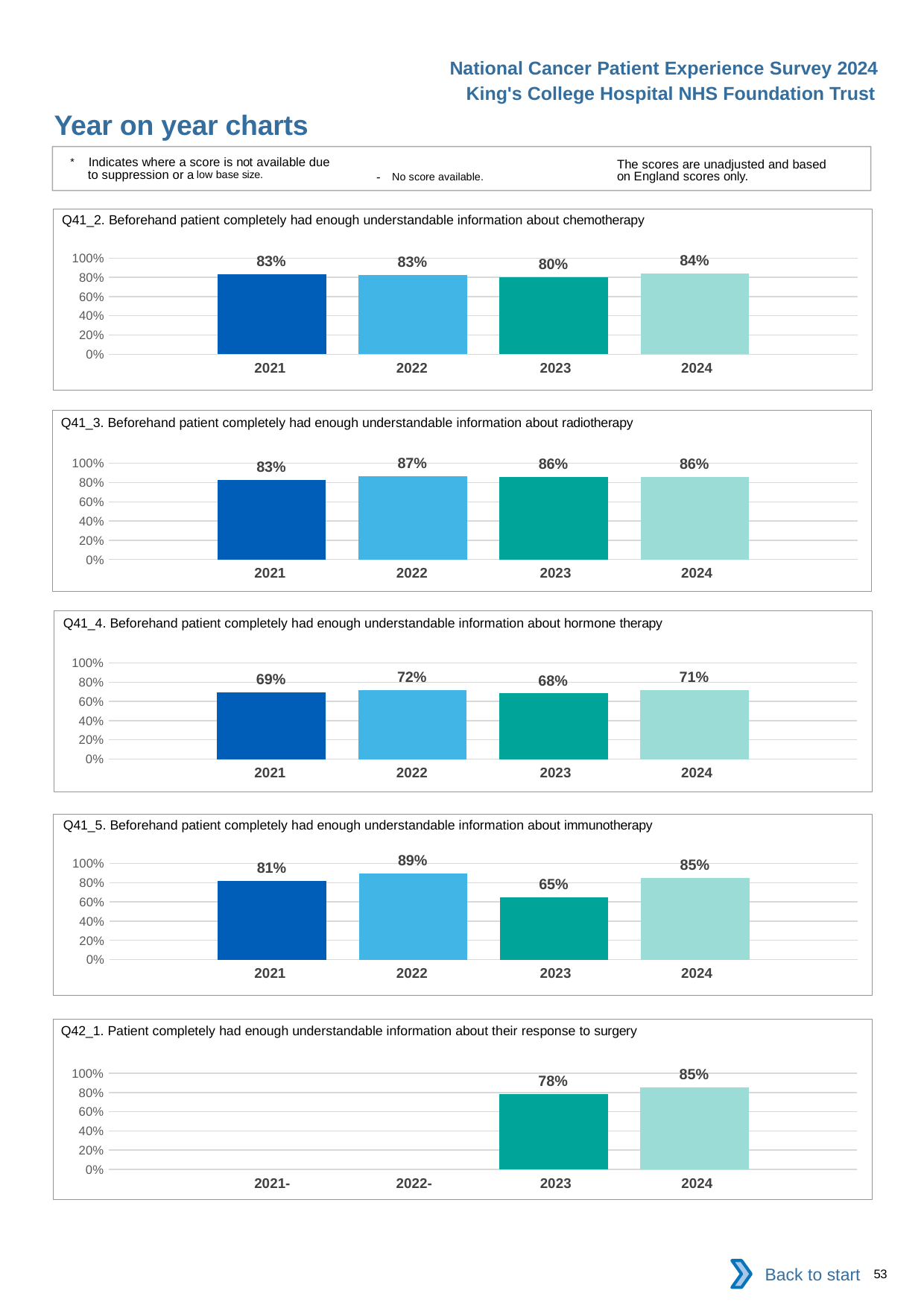
In the Q41_3 chart (radiotherapy), what is the difference between the 2022 and 2021 values? 4 percentage points In the Q41_4 chart (hormone therapy), which year has the highest value? 2022 In the Q41_5 chart (immunotherapy), which is larger, the value for 2022 or the value for 2024? 2022 In the Q42_1 chart (response to surgery), what is the value for 2024? 85% In the Q42_1 chart (response to surgery), how many years have a bar plotted? 2 In the Q41_5 chart (immunotherapy), what is the difference between the 2022 and 2023 values? 24 percentage points What type of chart is the Q41_2 chart (chemotherapy)? Bar chart In the Q41_5 chart (immunotherapy), what is the value for 2023? 65% In the Q41_2 chart (chemotherapy), what is the value for 2024? 84% In the Q41_2 chart (chemotherapy), which year has the lowest value? 2023 In the Q41_3 chart (radiotherapy), what is the value for 2022? 87% In the Q41_4 chart (hormone therapy), is the value for 2023 greater or less than 80%? less